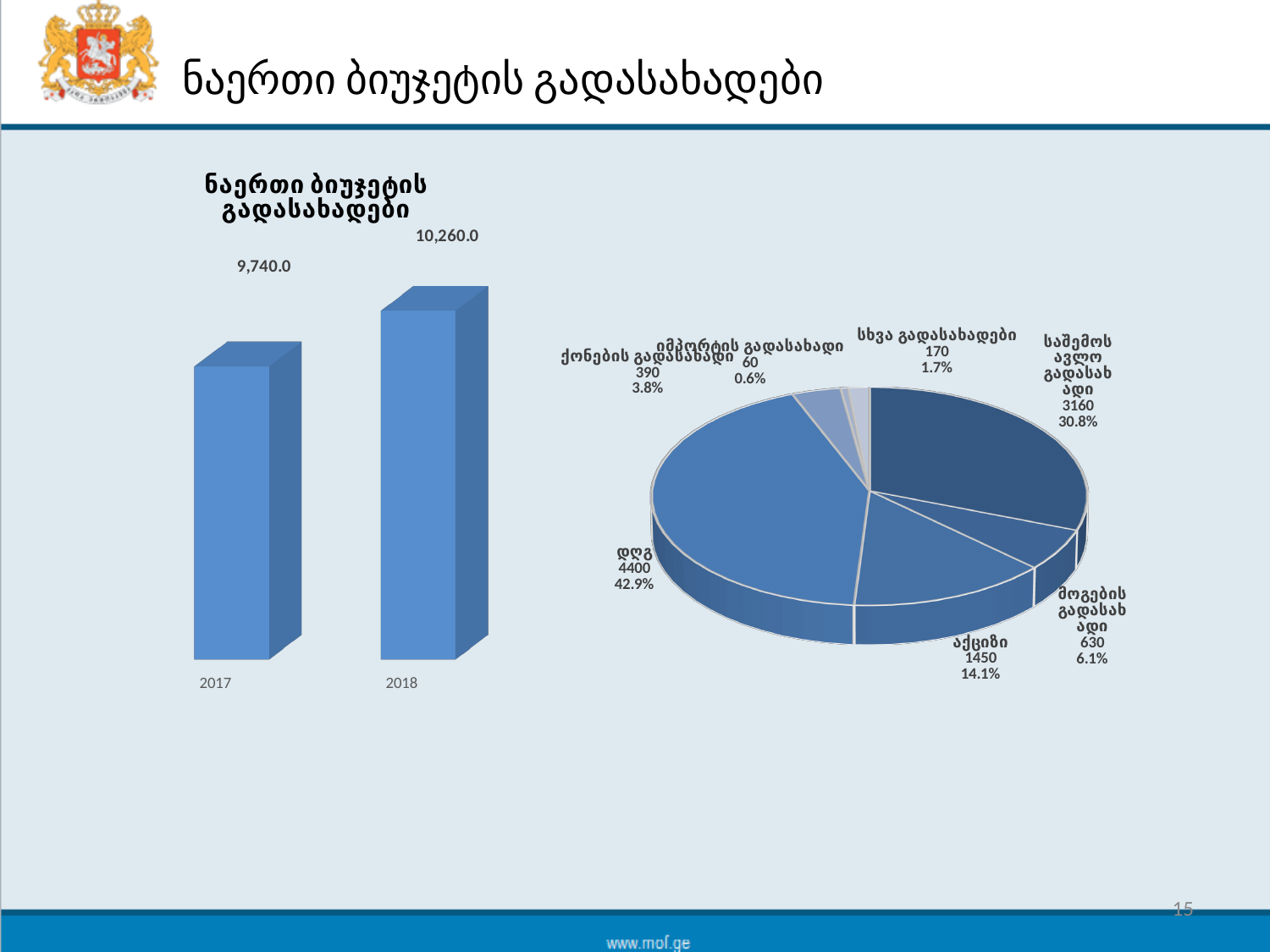
On the bar chart on the left, do the values rise or fall from 2017 to 2018? rise On the bar chart on the left, how many bars are plotted? 2 On the pie chart on the right, how many slices are there? 7 What type of chart is the chart on the left of the slide? bar chart On the pie chart on the right, which category has the smallest slice? იმპორტის გადასახადი On the bar chart on the left, which year has the higher value, 2017 or 2018? 2018 On the pie chart on the right, which category has the largest slice? დღგ On the pie chart on the right, what is the value for დღგ? 4400 On the bar chart on the left, what is the value for 2017? 9,740.0 On the bar chart on the left, what is the value for 2018? 10,260.0 On the bar chart on the left, what is the difference between the 2018 and 2017 values? 520.0 On the pie chart on the right, what share does საშემოსავლო გადასახადი have? 30.8%